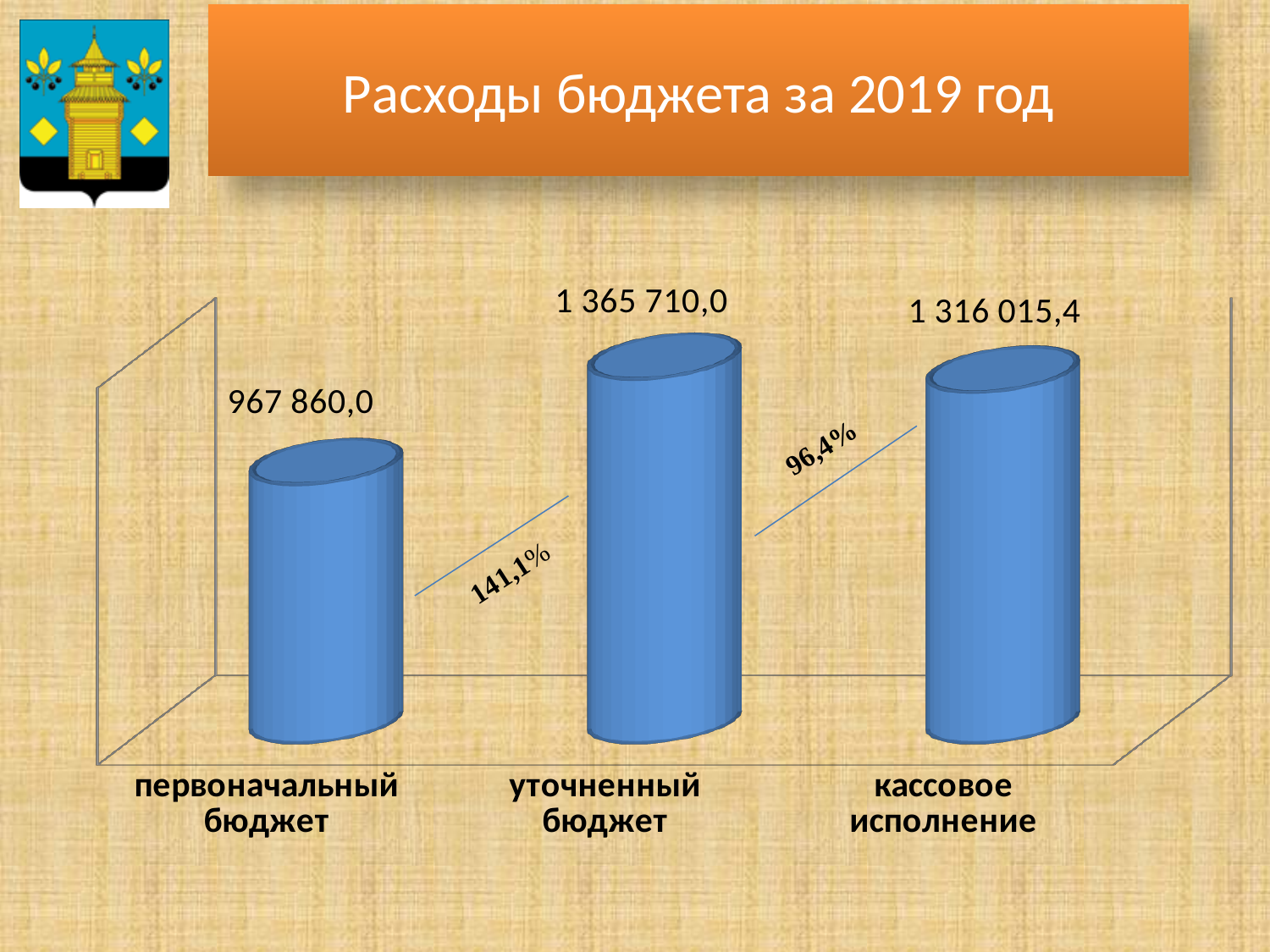
What is the value for первоначальный бюджет? 967 860,0 What kind of chart is shown on the slide? bar chart What percentage is shown on the connector between первоначальный бюджет and уточненный бюджет? 141,1% Which category has the lowest value? первоначальный бюджет What is the title of the chart? Расходы бюджета за 2019 год What is the difference between уточненный бюджет and первоначальный бюджет? 397 850,0 Which category has the highest value? уточненный бюджет What is the value for уточненный бюджет? 1 365 710,0 Which is larger, кассовое исполнение or первоначальный бюджет? кассовое исполнение How many categories are shown in the chart? 3 What is the value for кассовое исполнение? 1 316 015,4 What is the difference between уточненный бюджет and кассовое исполнение? 49 694,6